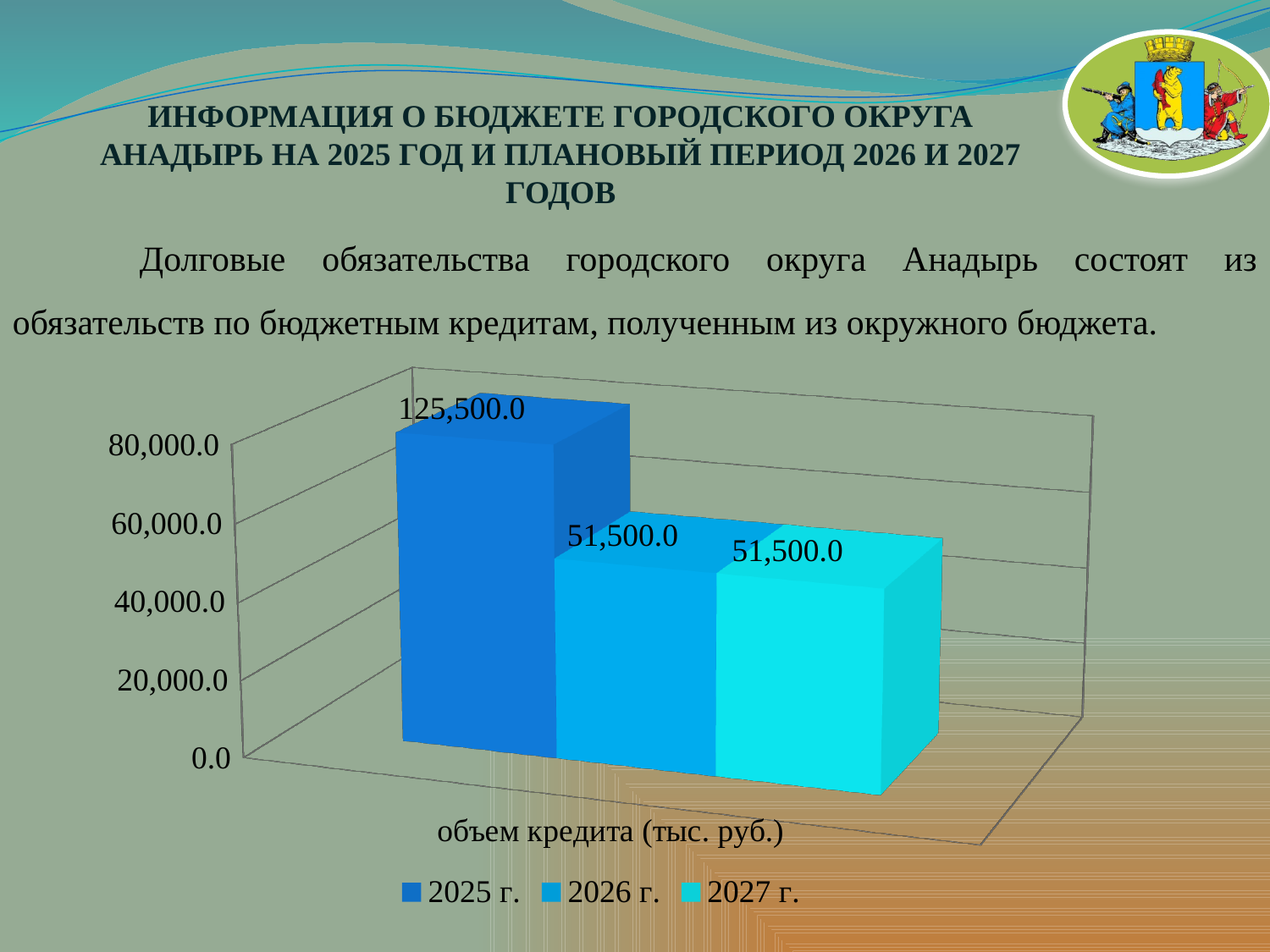
What kind of chart is shown on the slide? bar chart What is the value for 2025 г. in the chart? 125,500.0 How many categories are shown on the x axis of the chart? 1 What is the difference between the values for 2025 г. and 2026 г.? 74,000.0 Which is larger, the value for 2025 г. or the value for 2027 г.? 2025 г. Is the value for 2026 г. greater or less than 60,000.0? less What is the category label shown on the x axis of the chart? объем кредита (тыс. руб.) Which year has the highest value in the chart? 2025 г. What is the value for 2027 г. in the chart? 51,500.0 What is the value for 2026 г. in the chart? 51,500.0 How many series does the legend list? 3 Is the value for 2025 г. greater or less than 80,000.0? greater